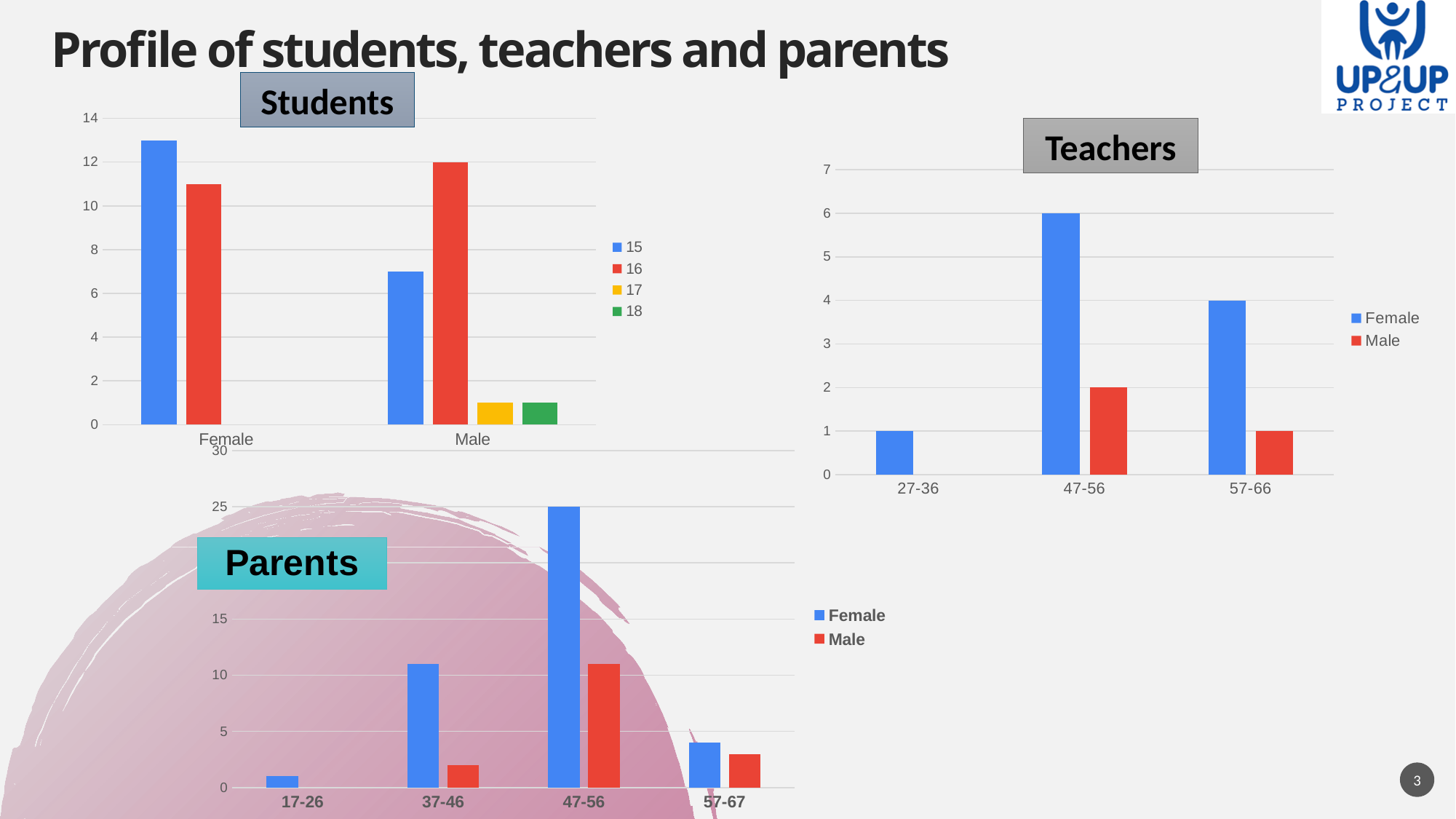
In the Teachers chart, how many age groups are shown on the x axis? 3 In the Teachers chart, what is the difference between the Female and Male values for the 47-56 age group? 4 In the Teachers chart, which age group has the highest Female value? 47-56 In the Teachers chart, what is the value for Male in the 47-56 age group? 2 In the Students chart, what is the value for the 16 series in the Male category? 12 In the Parents chart, is the value for Male in the 37-46 age group greater or less than 5? less In the Parents chart, how many age groups are shown on the x axis? 4 In the Students chart, is the value for the 15 series in the Female category greater or less than 12? greater In the Students chart, how many series does the legend list? 4 In the Students chart, which is larger for the Female category: the 15 series or the 16 series? 15 In the Teachers chart, what is the value for Female in the 47-56 age group? 6 In the Parents chart, what is the value for Female in the 47-56 age group? 25